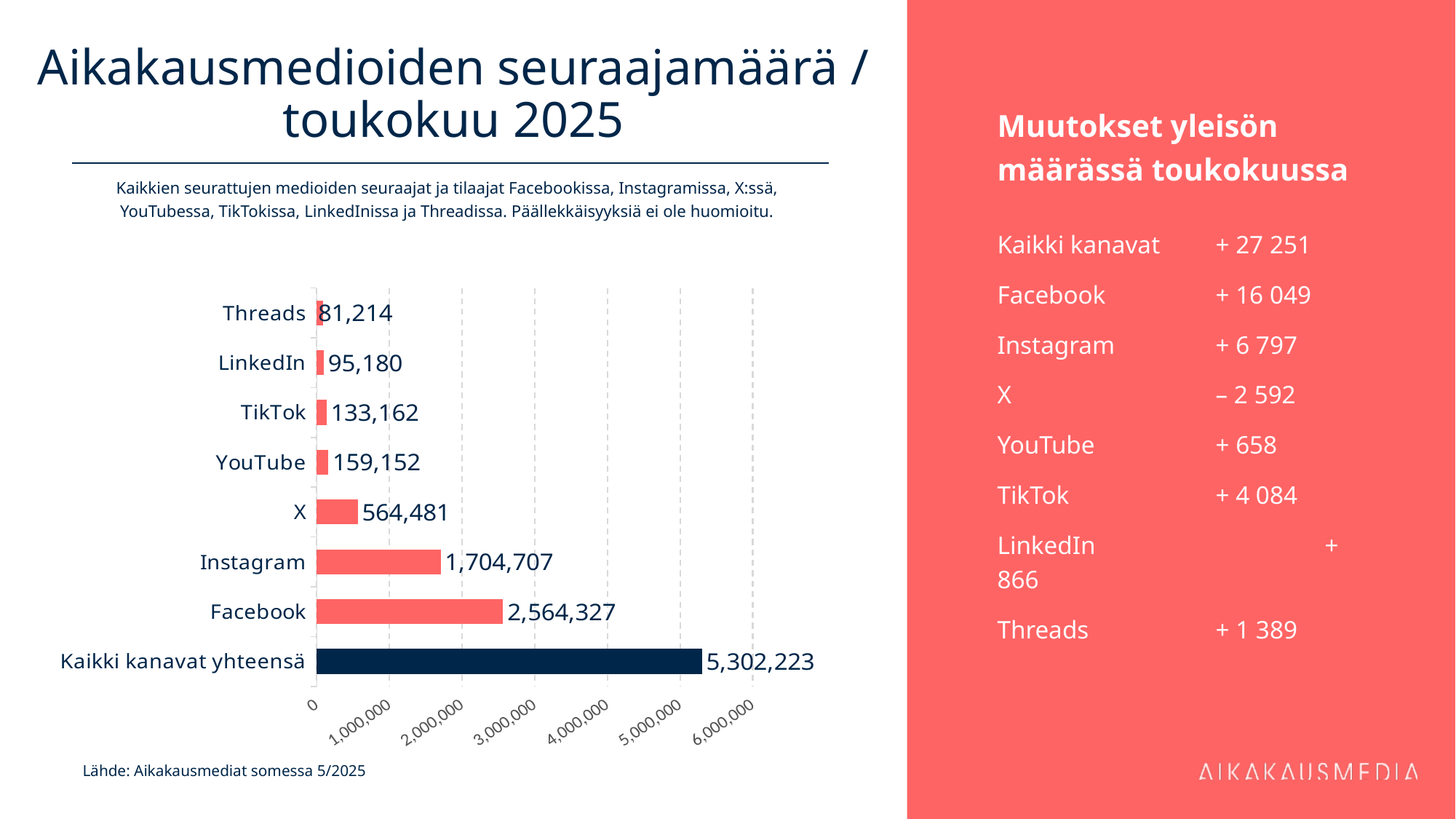
What kind of chart is shown on the slide? Bar chart What is the value for Facebook in the chart? 2,564,327 What is the value for 'Kaikki kanavat yhteensä' in the chart? 5,302,223 What is the difference between the values for YouTube and TikTok? 25,990 How many categories (bars) does the chart show? 8 What is the value for Instagram in the chart? 1,704,707 What is the value for TikTok in the chart? 133,162 Is the value for X greater or less than 1,000,000? less Which category has the lowest value in the chart? Threads What is the difference between the values for Facebook and Instagram? 859,620 Which individual channel (excluding the total bar) has the highest value? Facebook Which has a larger value, Instagram or X? Instagram